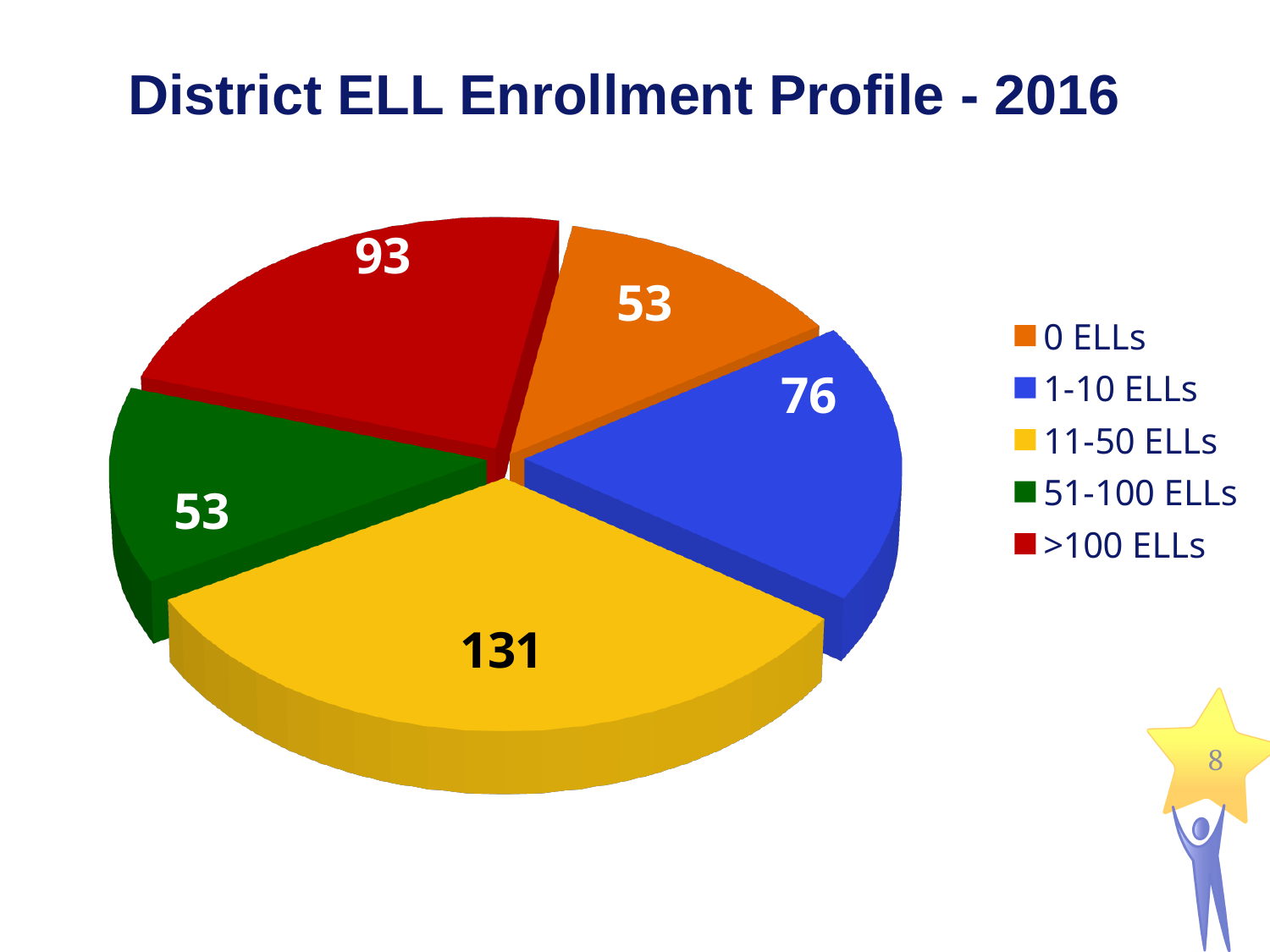
Which category has the largest slice of the pie? 11-50 ELLs Which is larger, the >100 ELLs slice or the 1-10 ELLs slice? >100 ELLs What is the value for the >100 ELLs slice? 93 What is the total of all the slices in the pie chart? 406 What is the difference between the 11-50 ELLs value and the >100 ELLs value? 38 What type of chart is shown on the slide? pie chart What is the value for the 0 ELLs slice? 53 What is the value for the 1-10 ELLs slice? 76 How many categories does the pie chart have? 5 What is the value for the 11-50 ELLs slice? 131 What is the title of the chart? District ELL Enrollment Profile - 2016 What is the difference between the 1-10 ELLs value and the 51-100 ELLs value? 23